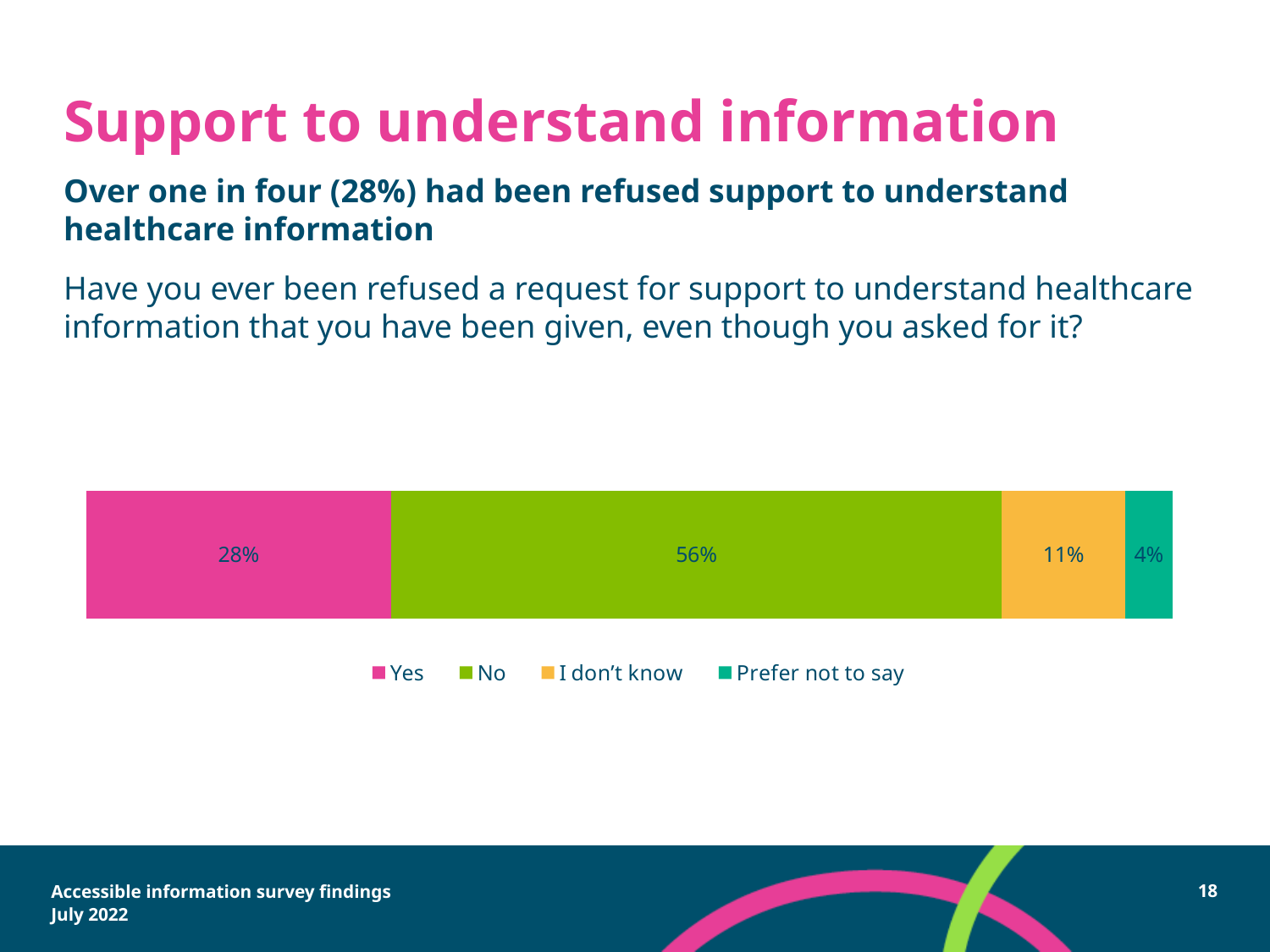
How many response categories does the legend list? 4 What colour is the "No" segment of the bar? Green Which is larger, the share for "Yes" or the share for "I don't know"? Yes Which response has the largest share? No What percentage of respondents answered "I don't know"? 11% Which response has the smallest share? Prefer not to say What kind of chart is shown on the slide? Stacked bar chart What percentage of respondents answered "No"? 56% What is the total of all the segments in the stacked bar? 99% What is the difference in percentage points between "No" and "Yes"? 28 What percentage of respondents answered "Prefer not to say"? 4% What percentage of respondents answered "Yes"? 28%